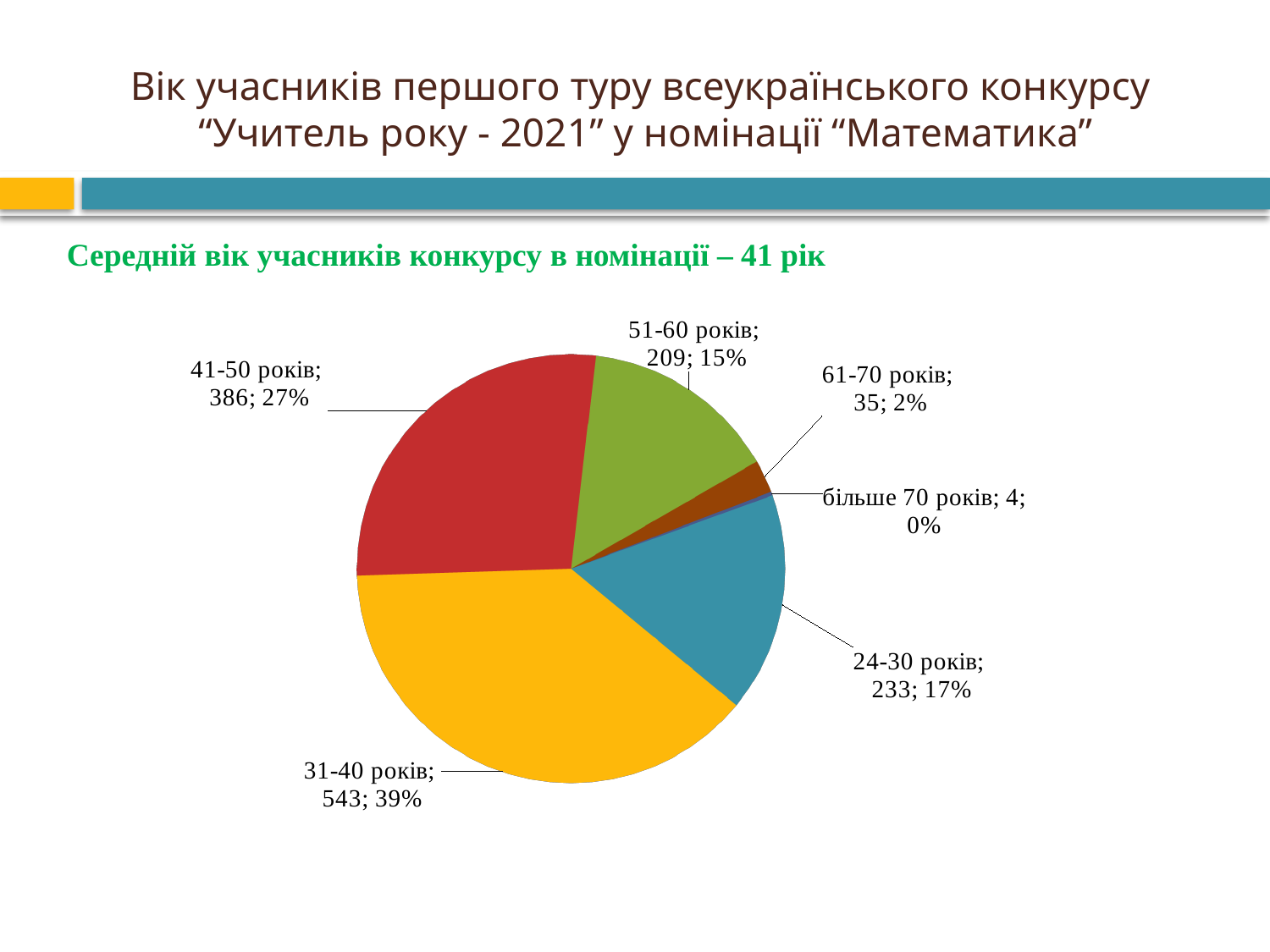
What is the difference in participants between the 41-50 років and 24-30 років groups? 153 What kind of chart is shown on the slide? pie chart What is the total number of participants across all slices of the pie? 1410 How many age groups (slices) does the pie chart show? 6 How many participants are in the 61-70 років age group? 35 Which age group has the largest slice of the pie? 31-40 років How many participants are in the 31-40 років age group? 543 Which age group has the smallest slice of the pie? більше 70 років What percentage share does the 41-50 років slice have? 27% According to the text above the chart, what is the average age of the participants? 41 рік Which group has more participants: 24-30 років or 51-60 років? 24-30 років What percentage share does the 24-30 років slice have? 17%